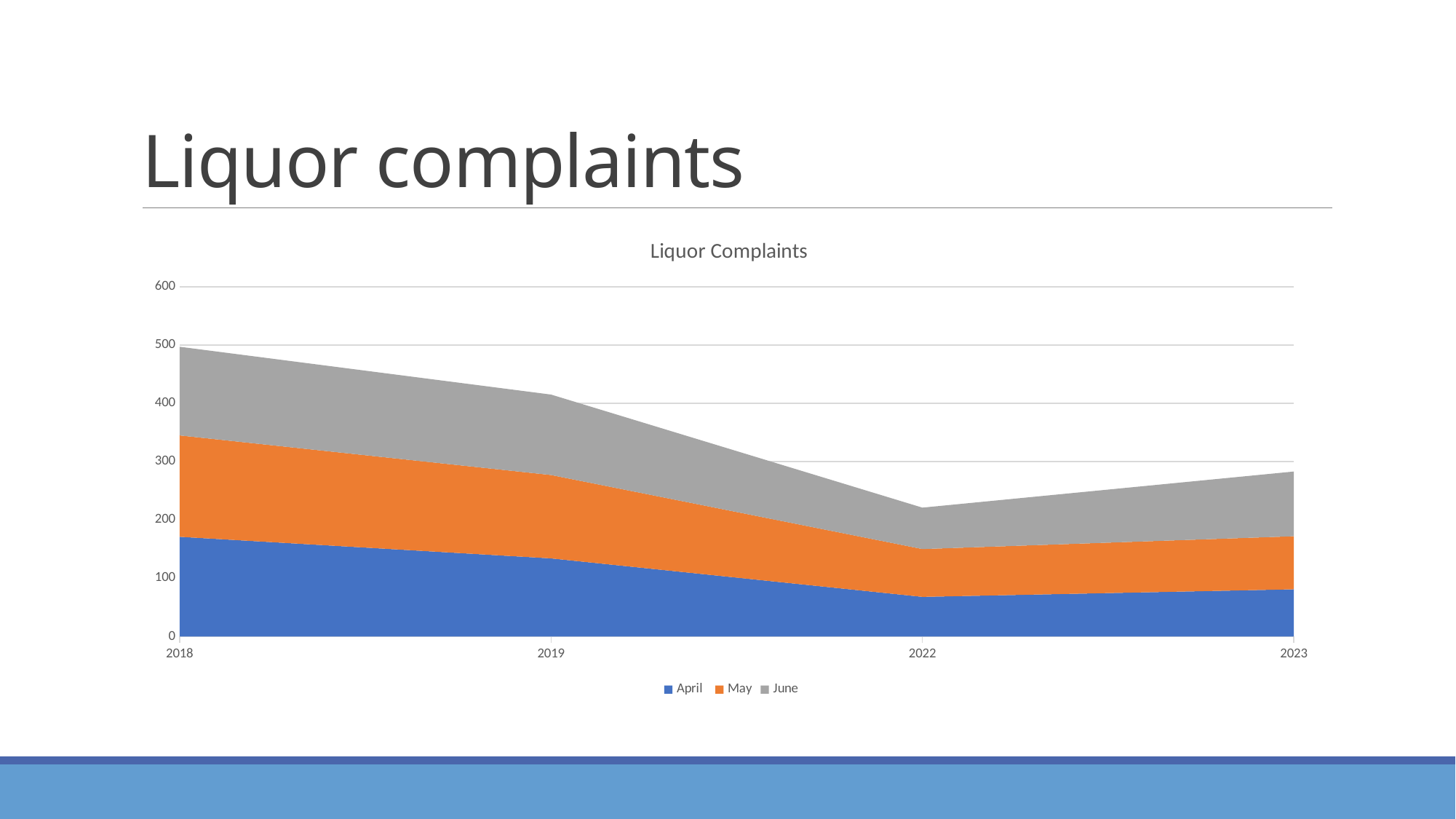
Which is larger, the total of liquor complaints in 2018 or in 2023? 2018 Which year has the highest total of liquor complaints? 2018 What is the title of the chart? Liquor Complaints Does the total of liquor complaints rise or fall from 2018 to 2022? fall Which series is shown in grey? June Is the value for April in 2018 greater or less than 100? greater Is the total of liquor complaints in 2022 greater or less than 300? less What kind of chart is shown on the slide? Stacked area chart How many years are shown on the x axis? 4 How many series does the legend list? 3 Which year has the lowest total of liquor complaints? 2022 Is the value for April in 2022 greater or less than 100? less